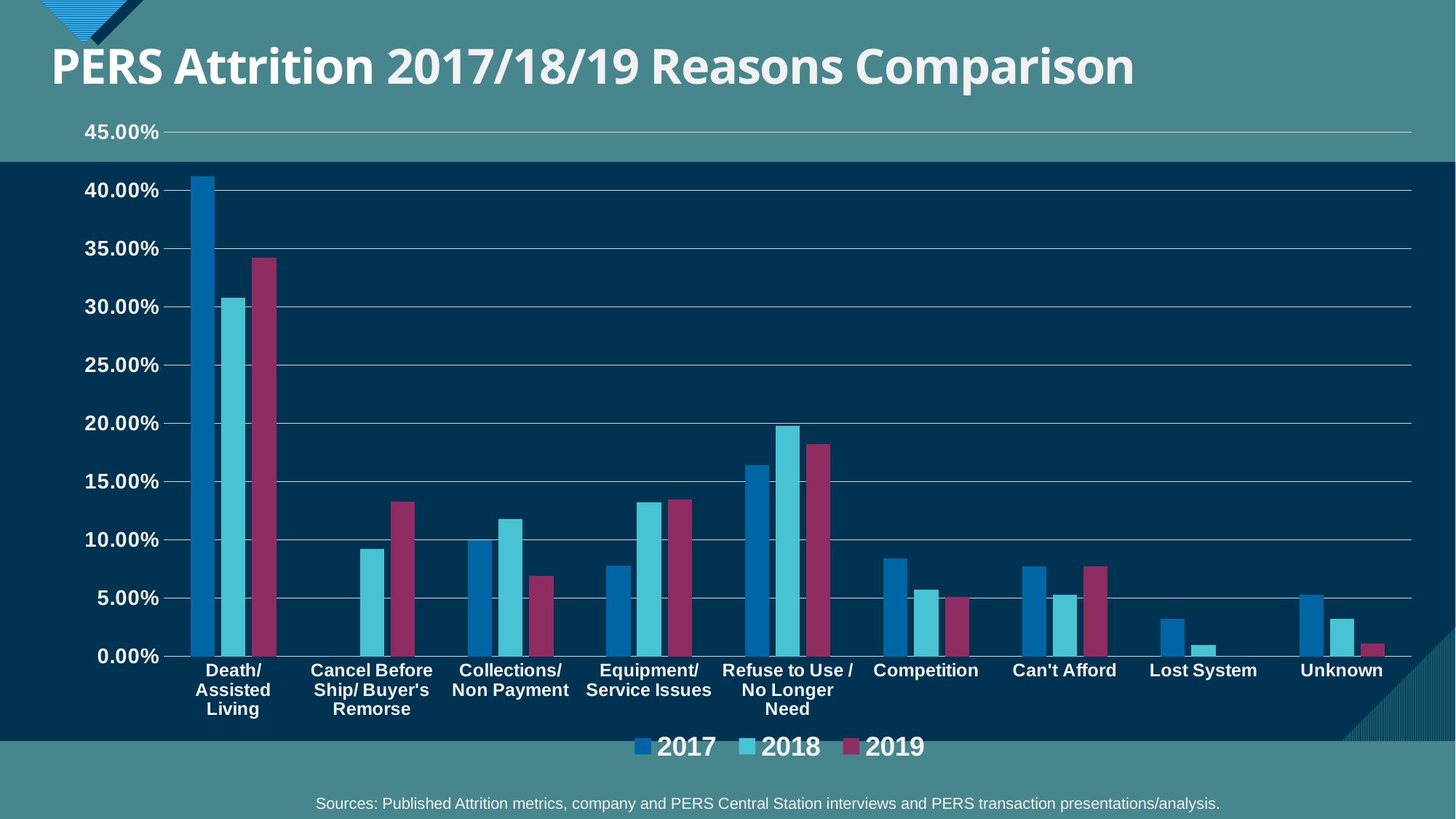
Is the 2017 value for Death/ Assisted Living greater or less than 40.00%? greater For Death/ Assisted Living, which is larger: the 2018 value or the 2019 value? 2019 Which category has the highest 2018 value? Death/ Assisted Living For the Unknown category, do the values rise or fall from 2017 to 2019? fall What kind of chart is shown on the slide? bar chart How many series does the legend list? 3 For Collections/ Non Payment, which is larger: the 2018 value or the 2019 value? 2018 Is the 2017 value for Competition greater or less than 10.00%? less How many reason categories are shown on the x axis? 9 Which category has the lowest 2018 value? Lost System Which category has the highest 2017 value? Death/ Assisted Living Is the 2017 value for Refuse to Use / No Longer Need greater or less than 15.00%? greater